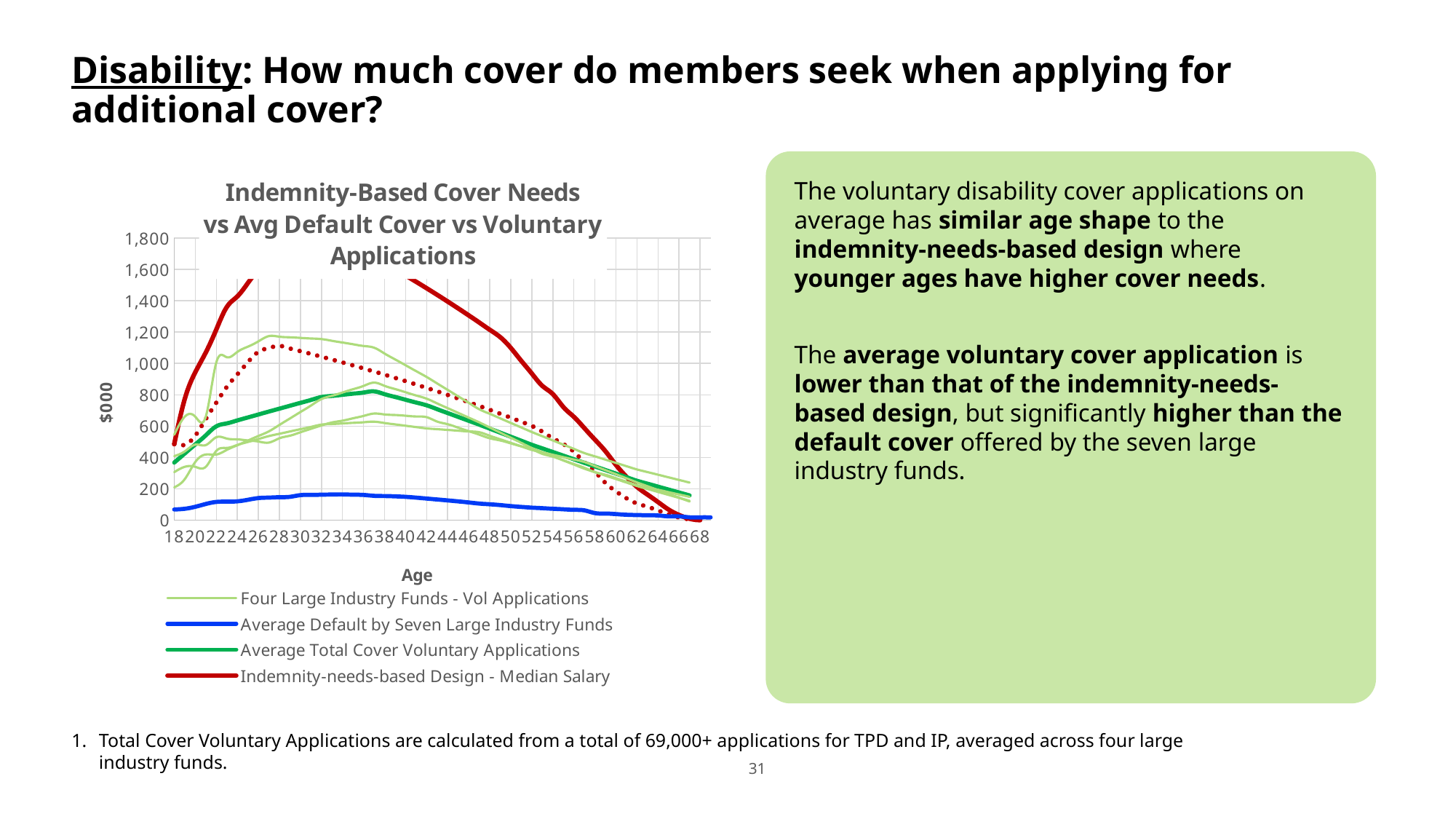
Which series has the lowest value at age 30? Average Default by Seven Large Industry Funds Which series has the highest value at age 48? Indemnity-needs-based Design - Median Salary How many series does the chart legend list? 4 What kind of chart is shown on the slide? Line chart Is the value for Indemnity-needs-based Design - Median Salary at age 24 greater or less than 1,200? greater What is the title of the chart? Indemnity-Based Cover Needs vs Avg Default Cover vs Voluntary Applications Does the Indemnity-needs-based Design - Median Salary line rise or fall from age 40 to age 68? Fall Is the value for Average Total Cover Voluntary Applications at age 36 greater or less than 600? greater At age 40, which is larger: Indemnity-needs-based Design - Median Salary or Average Default by Seven Large Industry Funds? Indemnity-needs-based Design - Median Salary What is the label on the vertical axis of the chart? $000 Is the value for Indemnity-needs-based Design - Median Salary at age 48 greater or less than 1,000? greater